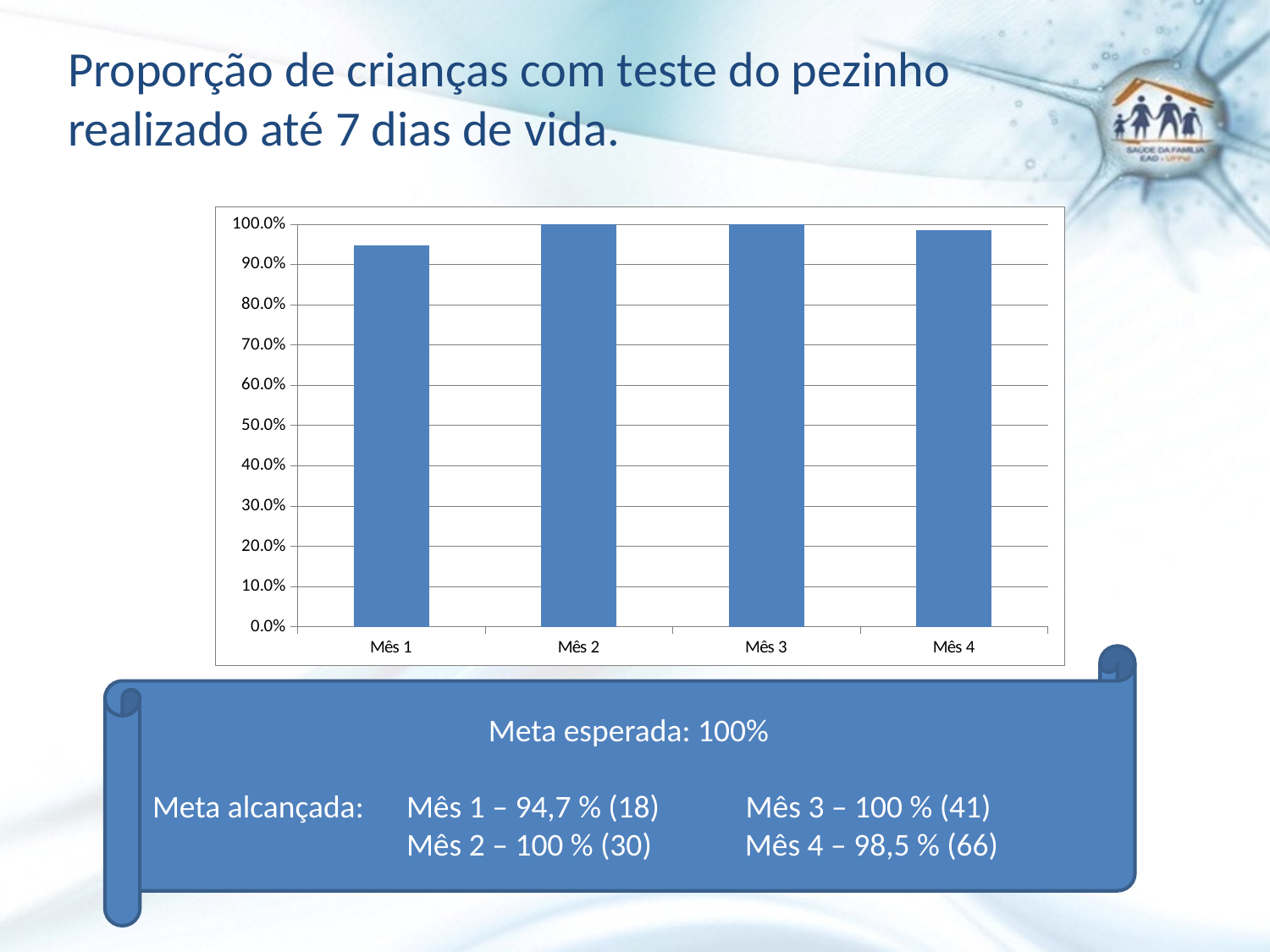
According to the slide, what proportion was achieved in Mês 1? 94,7 % Which is larger, the value for Mês 1 or the value for Mês 4? Mês 4 According to the slide, what proportion was achieved in Mês 4? 98,5 % Is the value for Mês 1 greater or less than 90.0%? greater What is the difference in percentage points between the values for Mês 4 and Mês 1 given on the slide? 3,8 Which months reach the 100.0% line on the chart? Mês 2 and Mês 3 How many months (categories) are plotted on the chart? 4 Which month has the lowest proportion of children with the heel-prick test done within 7 days? Mês 1 Is the value for Mês 4 greater or less than 90.0%? greater What kind of chart is shown on the slide? bar chart What is the expected target (meta esperada) stated on the slide? 100% According to the slide, what proportion was achieved in Mês 2? 100 %